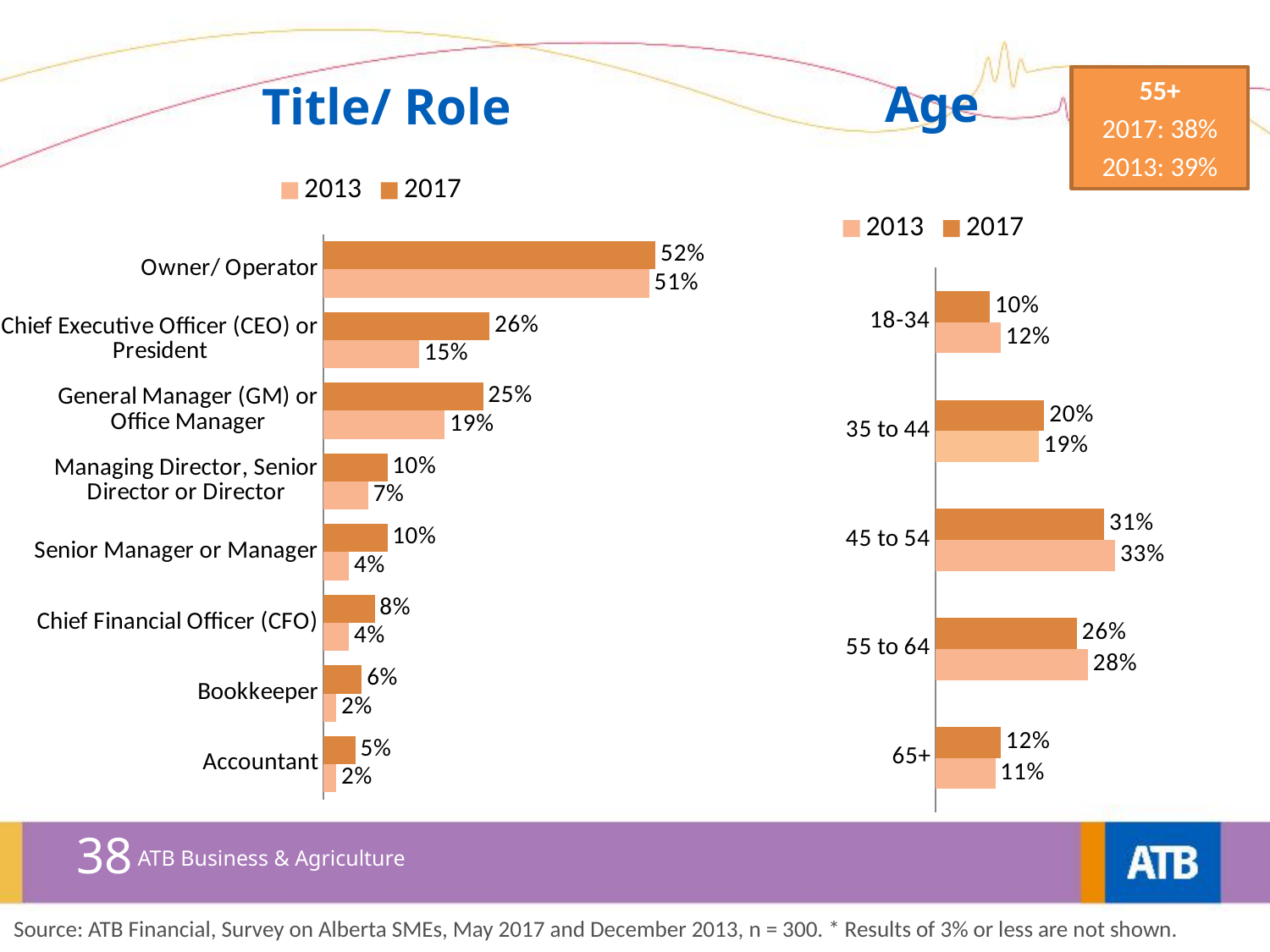
In the Title/ Role chart, what is the 2017 value for Owner/ Operator? 52% In the Title/ Role chart, which role has the highest 2017 value? Owner/ Operator In the Title/ Role chart, what is the difference between the 2017 and 2013 values for General Manager (GM) or Office Manager? 6% In the Age chart, what is the 2013 value for 45 to 54? 33% In the Title/ Role chart, what is the 2013 value for Chief Executive Officer (CEO) or President? 15% In the Title/ Role chart, which is larger for Senior Manager or Manager, the 2013 value or the 2017 value? 2017 How many series does the legend of the Age chart list? 2 In the Title/ Role chart, how many roles are listed? 8 In the Age chart, which age group has the lowest 2017 value? 18-34 In the Age chart, what is the 2017 value for 55 to 64? 26% What type of chart is the Age chart? Bar chart In the Age chart, what is the difference between the 2013 and 2017 values for 18-34? 2%